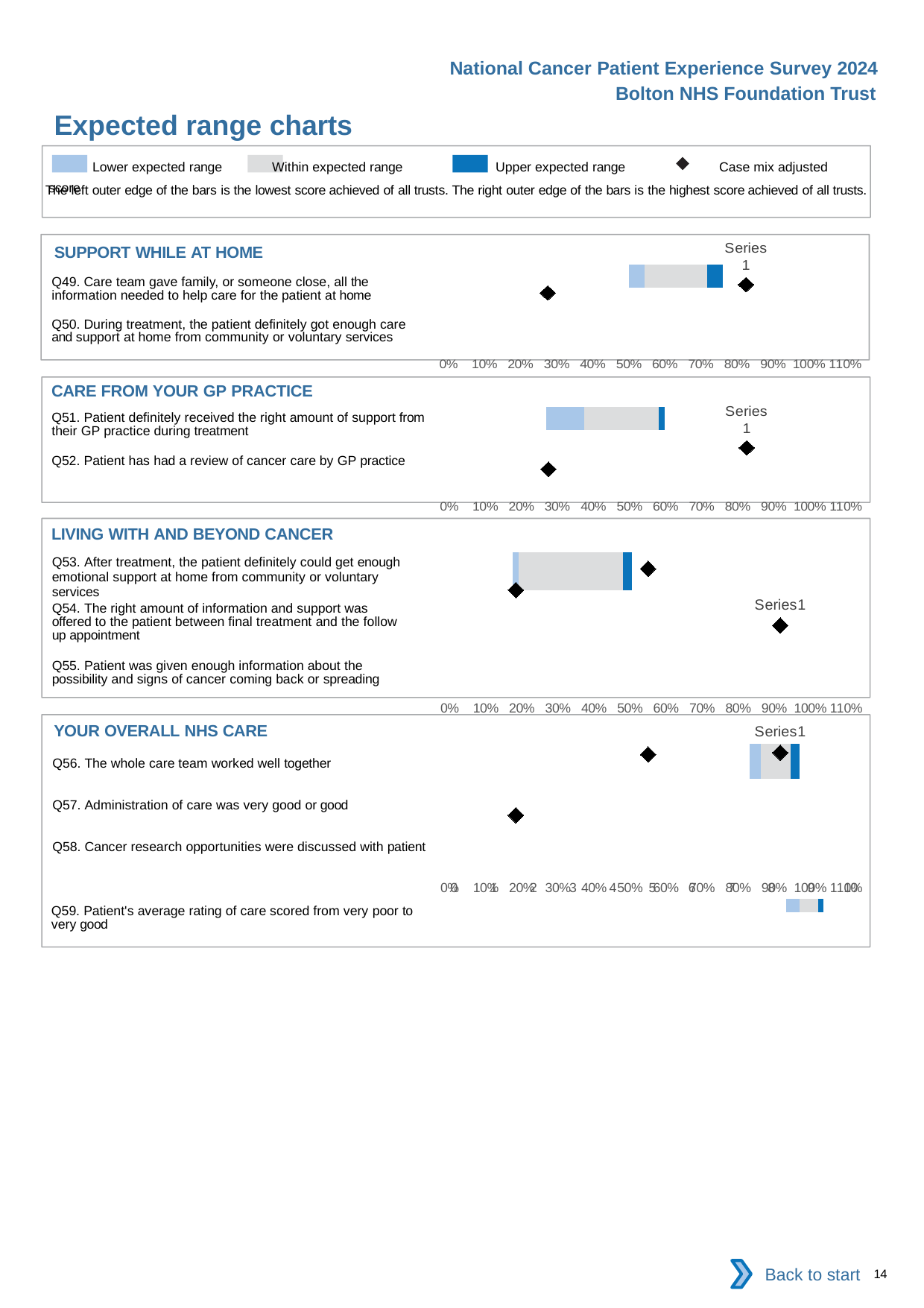
How many questions are listed in the SUPPORT WHILE AT HOME chart? 2 In the CARE FROM YOUR GP PRACTICE chart, is the value of the leftmost diamond marker greater or less than 50%? less What kind of chart is used in the SUPPORT WHILE AT HOME section? Bar chart In the SUPPORT WHILE AT HOME chart, is the value of the rightmost diamond marker greater or less than 70%? greater How many questions are listed in the YOUR OVERALL NHS CARE chart? 4 According to the legend, what does the black diamond marker represent? Case mix adjusted score How many questions are listed in the CARE FROM YOUR GP PRACTICE chart? 2 How many entries does the legend at the top of the slide list? 4 What is the highest percentage tick shown on the x axis of the LIVING WITH AND BEYOND CANCER chart? 110% In the YOUR OVERALL NHS CARE chart, is the value of the lowest diamond marker greater or less than 40%? less